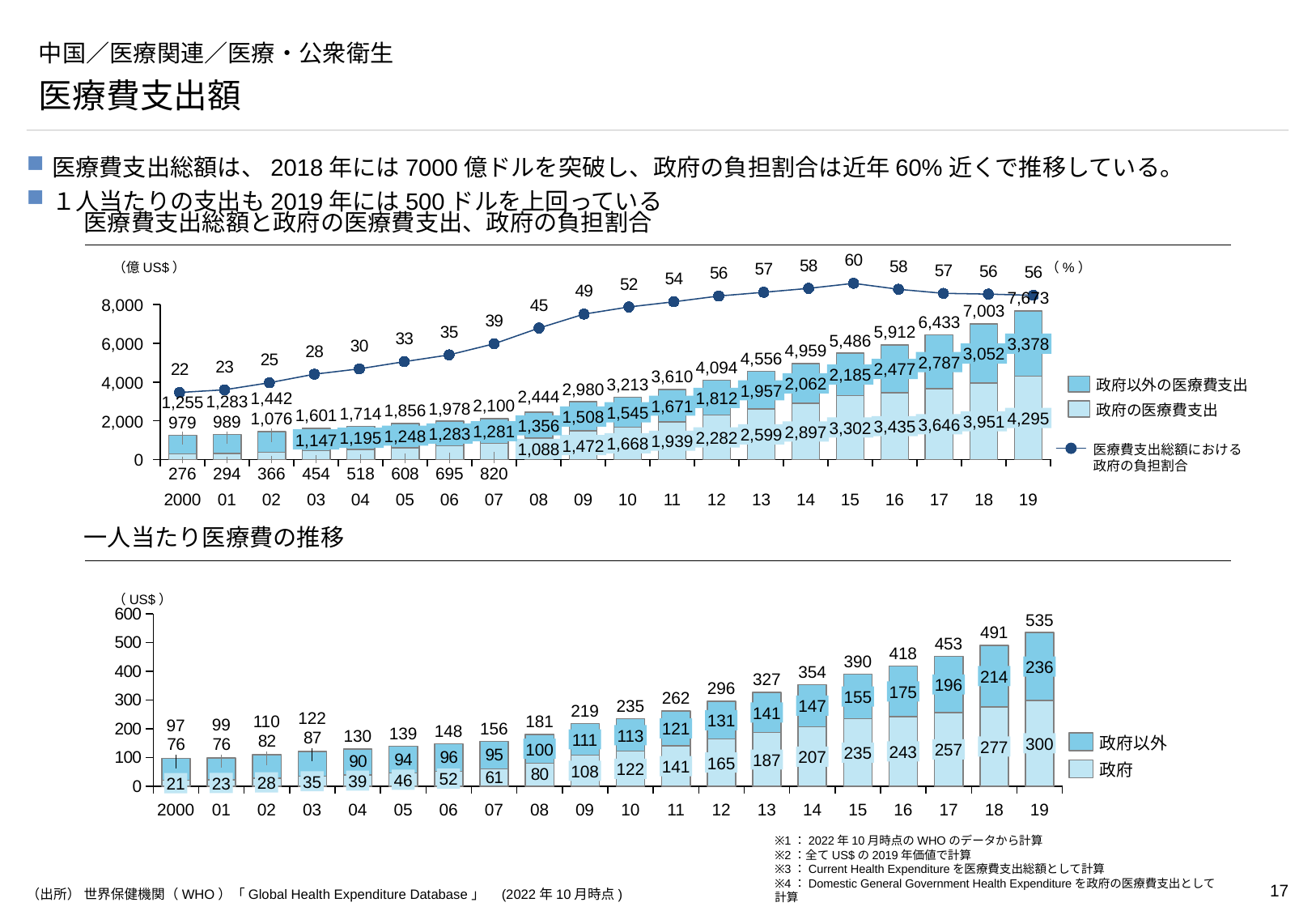
「一人当たり医療費の推移」のグラフは、何年分のデータを示していますか。 20 「一人当たり医療費の推移」のグラフで、2010年の政府の一人当たり医療費はいくらですか。 122 「医療費支出総額と政府の医療費支出、政府の負担割合」のグラフの凡例には、いくつの系列が示されていますか。 3 「医療費支出総額と政府の医療費支出、政府の負担割合」のグラフで、2019年の政府以外の医療費支出と政府の医療費支出の差はいくらですか。 917 「医療費支出総額と政府の医療費支出、政府の負担割合」のグラフで、2015年の医療費支出総額における政府の負担割合は何%ですか。 60 「医療費支出総額と政府の医療費支出、政府の負担割合」のグラフで、2018年の医療費支出総額（積み上げ合計）はいくらですか。 7,003 「一人当たり医療費の推移」のグラフで、一人当たり医療費の合計は2000年から2019年にかけて増加していますか、減少していますか。 増加 「一人当たり医療費の推移」のグラフで、2019年の政府と政府以外の差はいくらですか。 64 「医療費支出総額と政府の医療費支出、政府の負担割合」のグラフで、政府の負担割合が最も高い年はどれですか。 2015年 「医療費支出総額と政府の医療費支出、政府の負担割合」のグラフで、2019年の政府の医療費支出はいくらですか。 4,295 「一人当たり医療費の推移」のグラフで、2019年の一人当たり医療費の合計はいくらですか。 535 「医療費支出総額と政府の医療費支出、政府の負担割合」のグラフで、2000年の政府以外の医療費支出と政府の医療費支出ではどちらが大きいですか。 政府以外の医療費支出